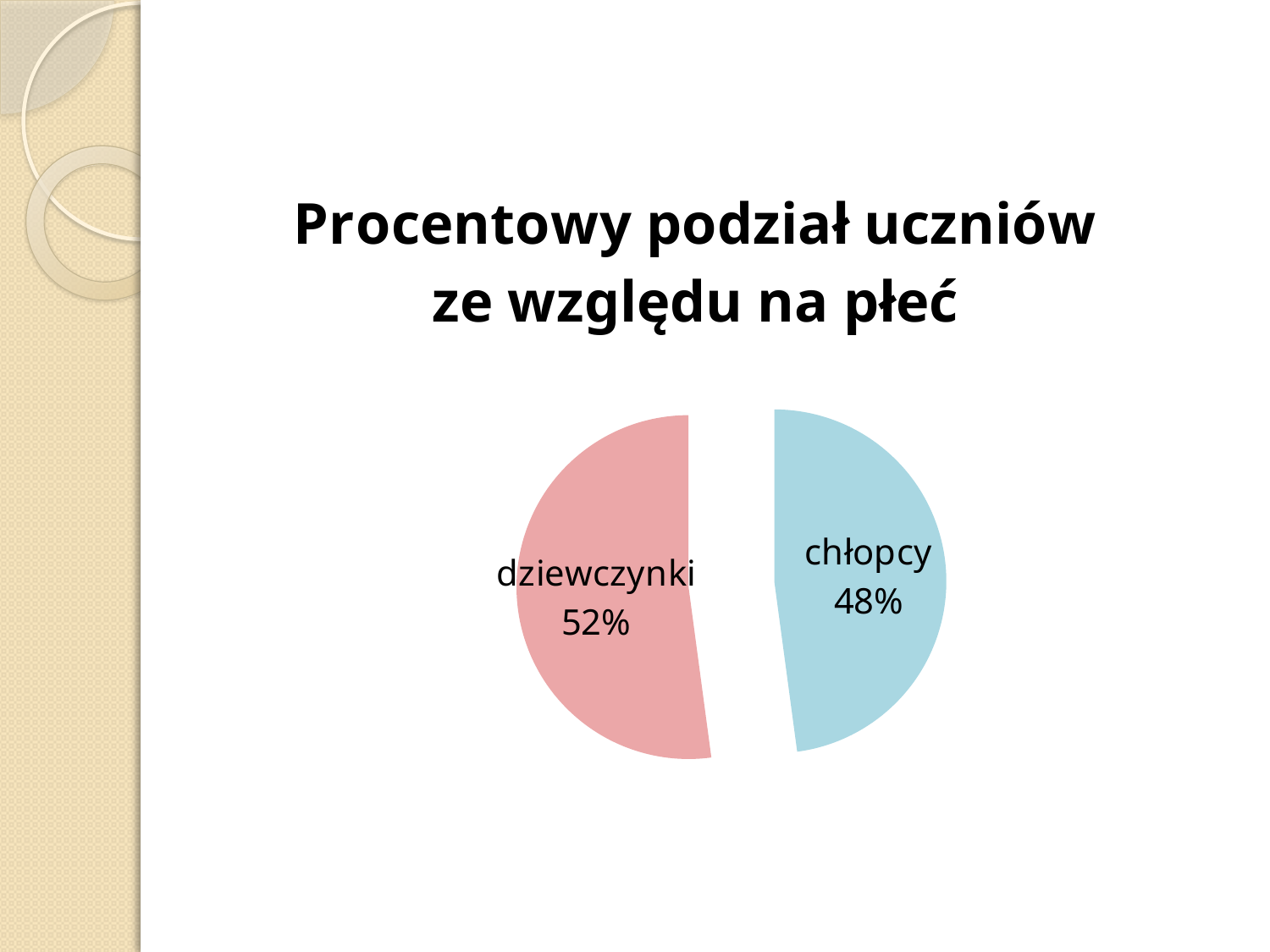
Is the share for chłopcy greater or less than 50%? less What kind of chart is shown on the slide? pie chart What percentage of students are chłopcy (boys)? 48% Which group has the larger share of students, dziewczynki or chłopcy? dziewczynki How many slices does the pie chart have? 2 What percentage of students are dziewczynki (girls)? 52% What colour is the chłopcy slice? light blue What is the difference in percentage points between the dziewczynki and chłopcy slices? 4 Which category has the smallest slice of the pie? chłopcy What is the title of the chart? Procentowy podział uczniów ze względu na płeć Which category has the largest slice of the pie? dziewczynki What is the combined share of the dziewczynki and chłopcy slices? 100%